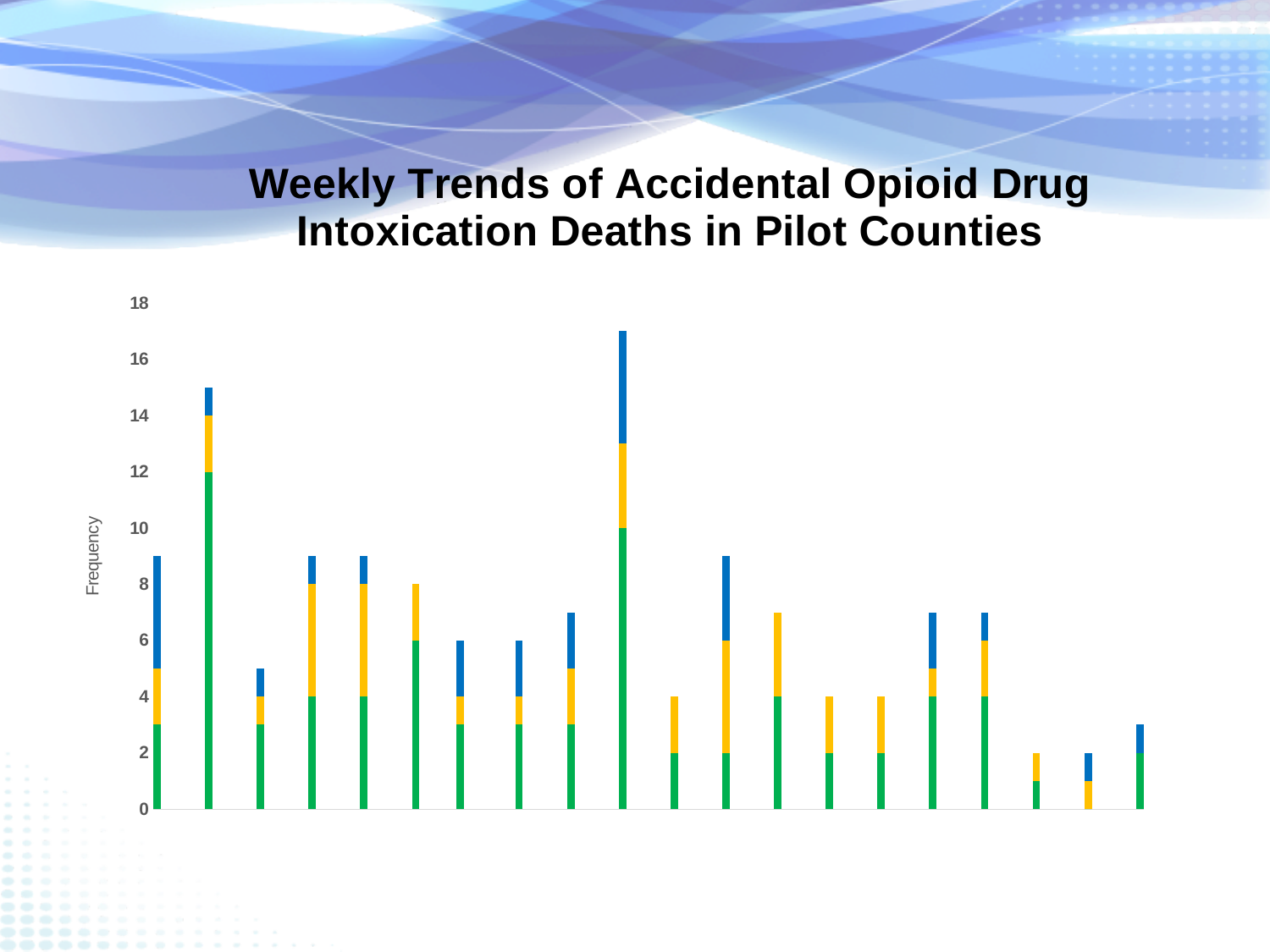
Is the total of the last bar on the right greater or less than 4? less Is the total of the third bar from the right greater or less than 4? less What is the title of the chart? Weekly Trends of Accidental Opioid Drug Intoxication Deaths in Pilot Counties Is the total of the second bar from the left greater or less than 14? greater What is the highest value shown on the vertical axis? 18 How many bars are plotted in the chart? 20 What is the label on the vertical axis of the chart? Frequency Which is taller, the tallest bar in the middle of the chart or the second bar from the left? The tallest bar in the middle What kind of chart is shown on the slide? Stacked bar chart